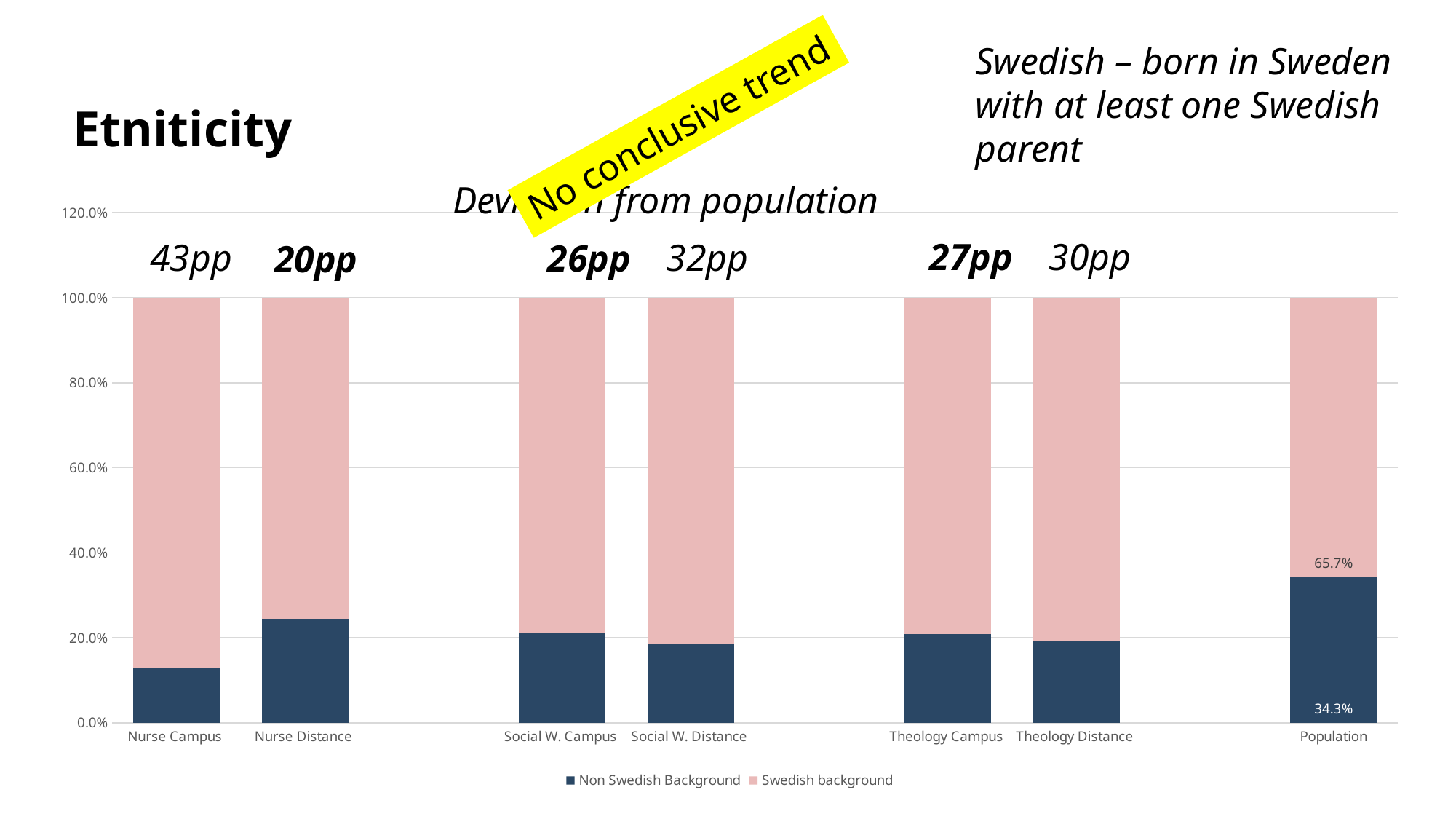
How many categories are shown on the x axis of the chart? 7 Which has the larger Non Swedish Background share, Nurse Campus or Nurse Distance? Nurse Distance Which category has the highest Non Swedish Background share? Population Which colour represents Non Swedish Background in the legend? Dark blue How many series does the chart legend list? 2 Is the Non Swedish Background value for Social W. Distance greater or less than 20.0%? less Which category has the lowest Non Swedish Background share? Nurse Campus What is the total of the stacked bar for Population? 100.0% What is the Non Swedish Background value for Population? 34.3% What kind of chart is shown on the slide? Stacked bar chart What is the Swedish background value for Population? 65.7% Is the Non Swedish Background value for Nurse Distance greater or less than 20.0%? greater